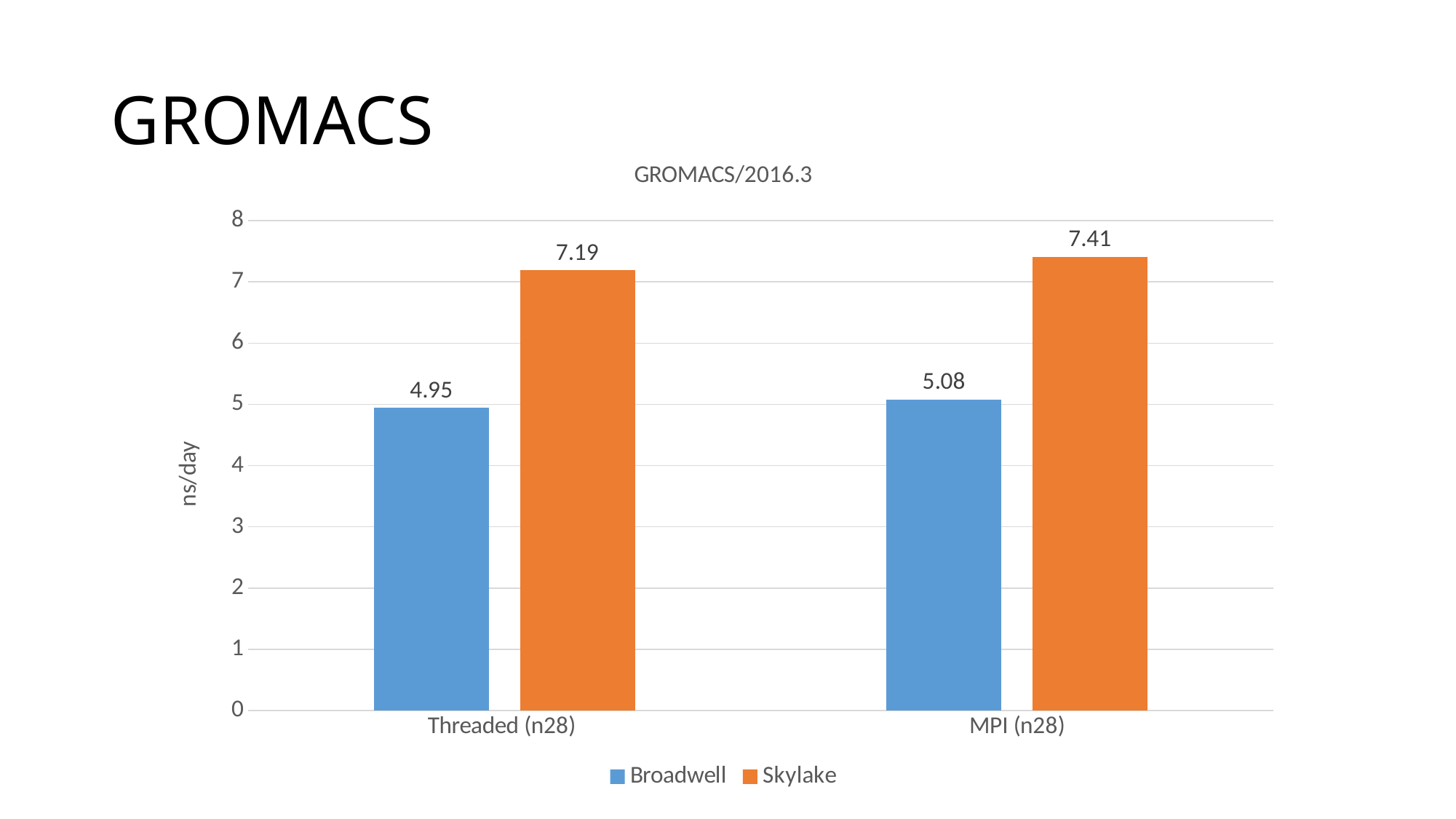
Which bar has the highest value on the chart? Skylake, MPI (n28) Which is larger for Threaded (n28): Broadwell or Skylake? Skylake What is the Broadwell value for Threaded (n28)? 4.95 How many series does the legend list? 2 What is the Skylake value for Threaded (n28)? 7.19 Which bar has the lowest value on the chart? Broadwell, Threaded (n28) How many categories are shown on the x axis? 2 What is the difference between the Skylake and Broadwell values for MPI (n28)? 2.33 What kind of chart is shown on the slide? Bar chart Is the Skylake value for Threaded (n28) greater or less than 7? greater What is the Broadwell value for MPI (n28)? 5.08 What is the Skylake value for MPI (n28)? 7.41